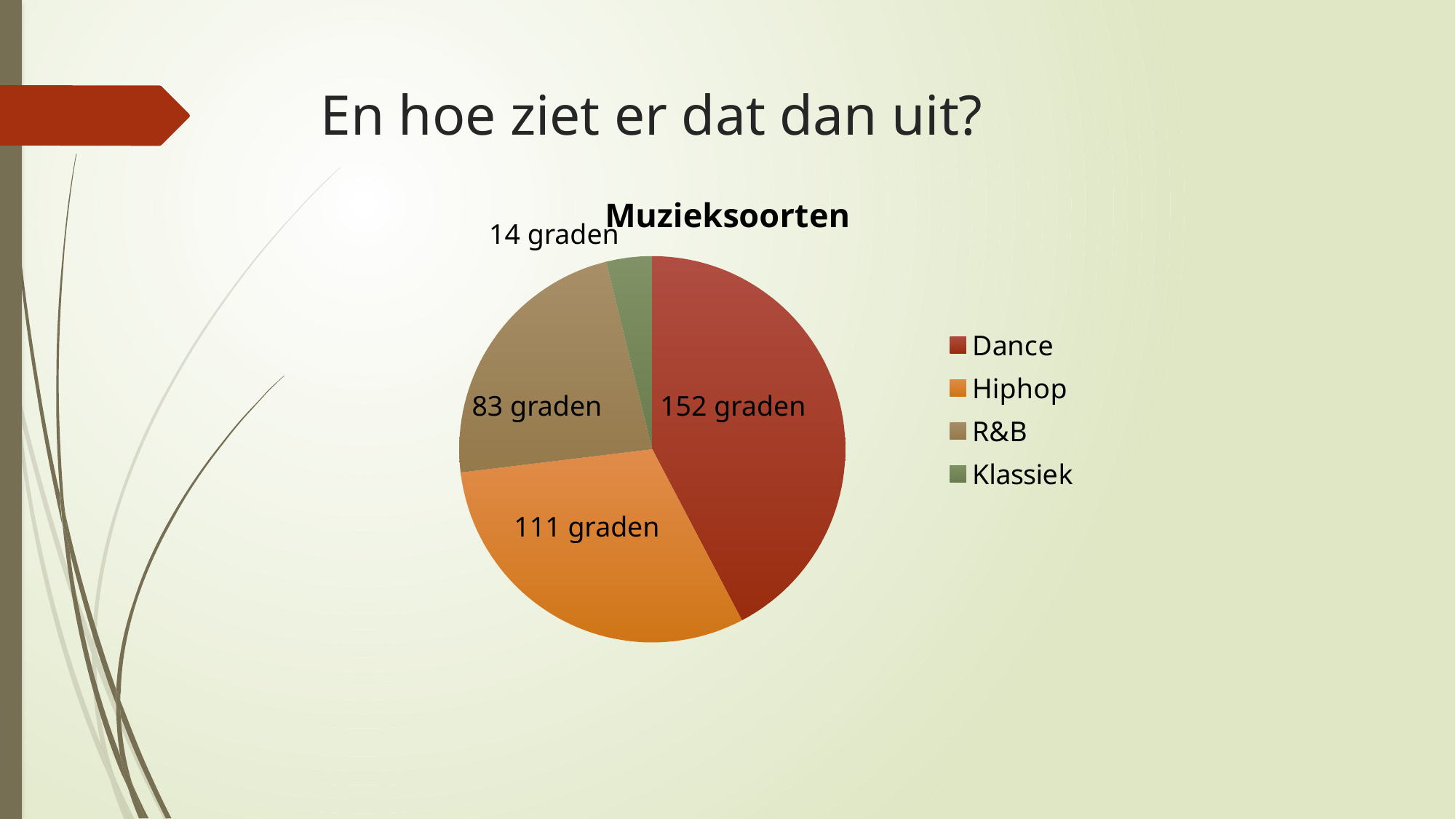
What is the value for Dance? 152 graden Which category has the largest slice? Dance What is the title of the chart? Muzieksoorten What kind of chart is shown on the slide? pie chart How many categories does the pie chart have? 4 Which category has the smallest slice? Klassiek What is the value for Hiphop? 111 graden What is the value for R&B? 83 graden What is the difference between the values for Dance and Hiphop? 41 graden What is the value for Klassiek? 14 graden How many entries does the legend list? 4 Which is larger, the value for R&B or the value for Hiphop? Hiphop